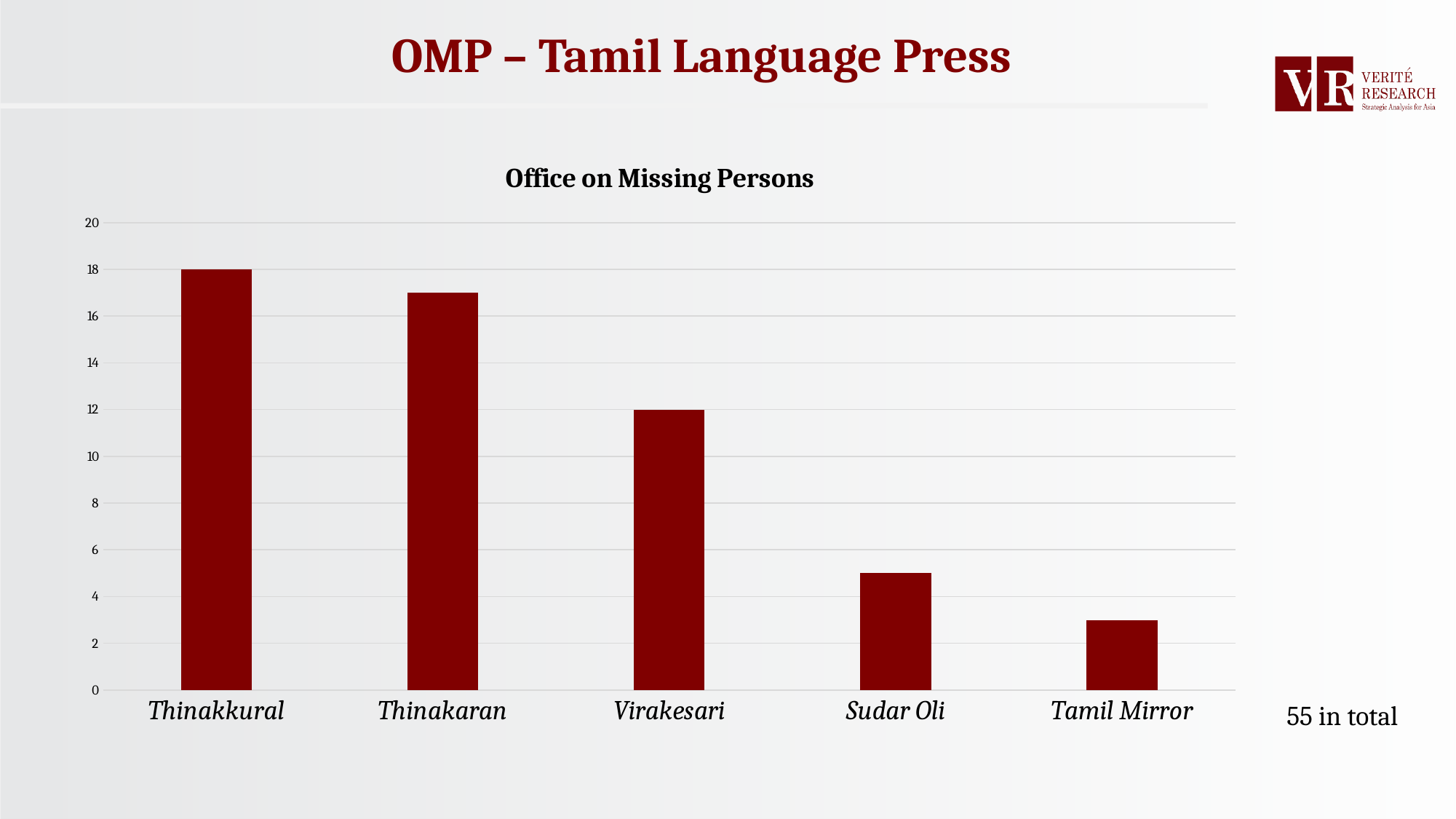
Which newspaper has the lowest value? Tamil Mirror What is the difference between the values for Thinakkural and Virakesari? 6 Is the value for Tamil Mirror greater or less than 4? less What kind of chart is shown on the slide? bar chart Which newspaper has the highest value? Thinakkural What is the value for Thinakkural? 18 Is the value for Sudar Oli greater or less than 6? less Is the value for Thinakaran greater or less than 16? greater Do the values rise or fall from left to right along the x axis? fall How many newspapers are shown on the x axis? 5 Which has a larger value, Virakesari or Sudar Oli? Virakesari What is the value for Virakesari? 12